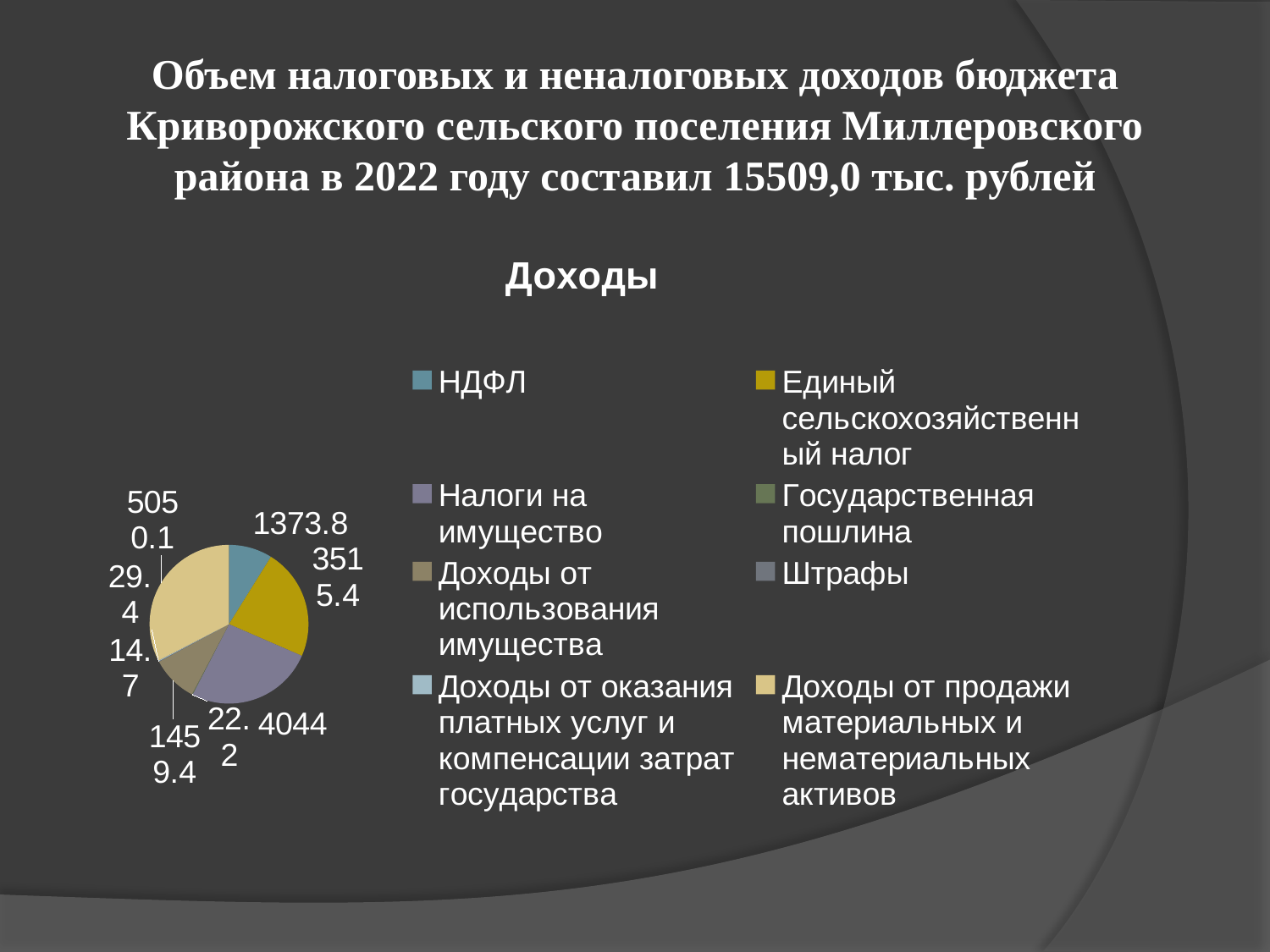
What is the value for Доходы от продажи материальных и нематериальных активов? 5050.1 Which is larger: Доходы от использования имущества or НДФЛ? Доходы от использования имущества How many categories does the chart's legend list? 8 What is the value for Единый сельскохозяйственный налог? 3515.4 What is the value for НДФЛ? 1373.8 What is the difference between Единый сельскохозяйственный налог and НДФЛ? 2141.6 What is the title of the chart? Доходы What is the value for Доходы от использования имущества? 1459.4 Which category has the largest slice of the pie? Доходы от продажи материальных и нематериальных активов What kind of chart is shown on the slide? pie chart Which is larger: Единый сельскохозяйственный налог or НДФЛ? Единый сельскохозяйственный налог What is the difference between Доходы от продажи материальных и нематериальных активов and Доходы от использования имущества? 3590.7